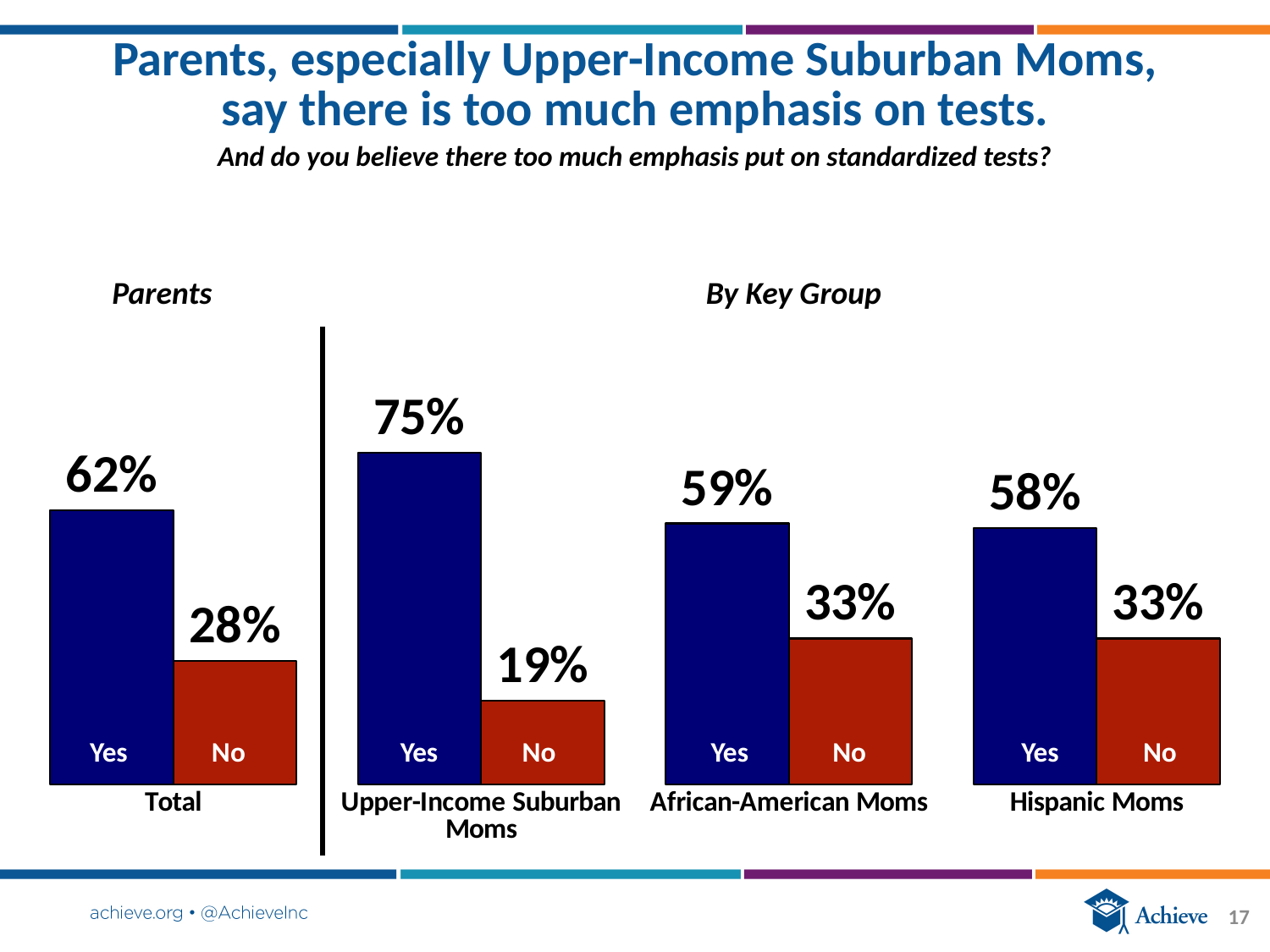
What percentage of Upper-Income Suburban Moms answered Yes? 75% What type of chart is shown on the slide? Bar chart What percentage of the Total group answered No? 28% What is the Yes value for African-American Moms? 59% Which is larger: the No percentage for African-American Moms or the No percentage for the Total group? African-American Moms How much higher is the Yes percentage for Upper-Income Suburban Moms than for the Total group? 13% Which group has the lowest No percentage? Upper-Income Suburban Moms What is the difference between the Yes and No percentages for Upper-Income Suburban Moms? 56% What colour are the Yes bars? Blue How many groups are shown in the chart? 4 What is the No value for Hispanic Moms? 33% Which group has the highest Yes percentage? Upper-Income Suburban Moms